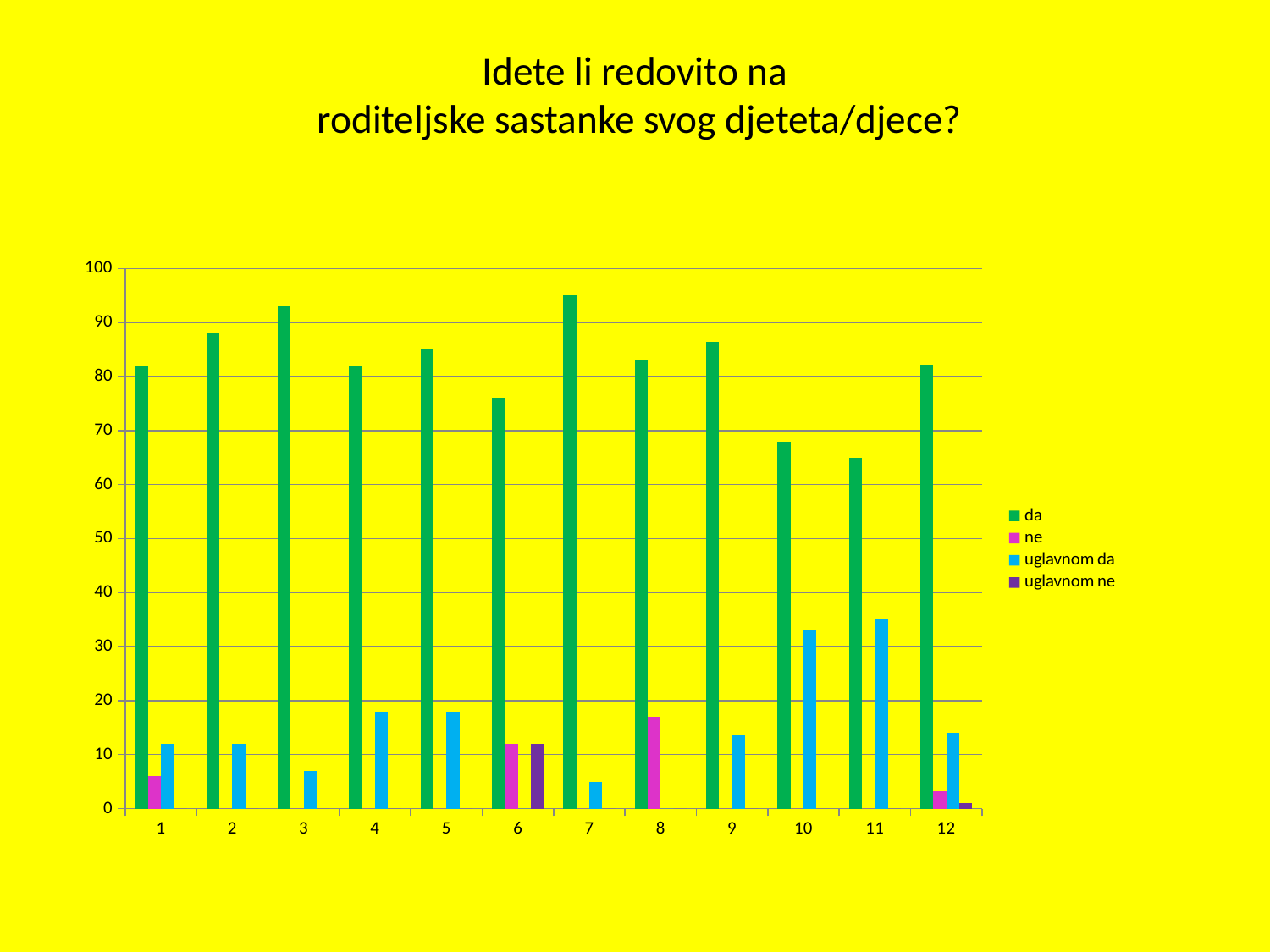
What is the title of the chart? Idete li redovito na roditeljske sastanke svog djeteta/djece? How many series does the legend list? 4 What kind of chart is shown on the slide? bar chart Which is larger, the "da" value for category 3 or for category 10? category 3 What colour represents the "da" series in the legend? green Is the value of "ne" for category 8 greater or less than 10? greater Which is larger, the "uglavnom da" value for category 11 or for category 1? category 11 Is the value of "da" for category 7 greater or less than 90? greater Is the value of "uglavnom da" for category 3 greater or less than 10? less How many categories are shown on the x axis? 12